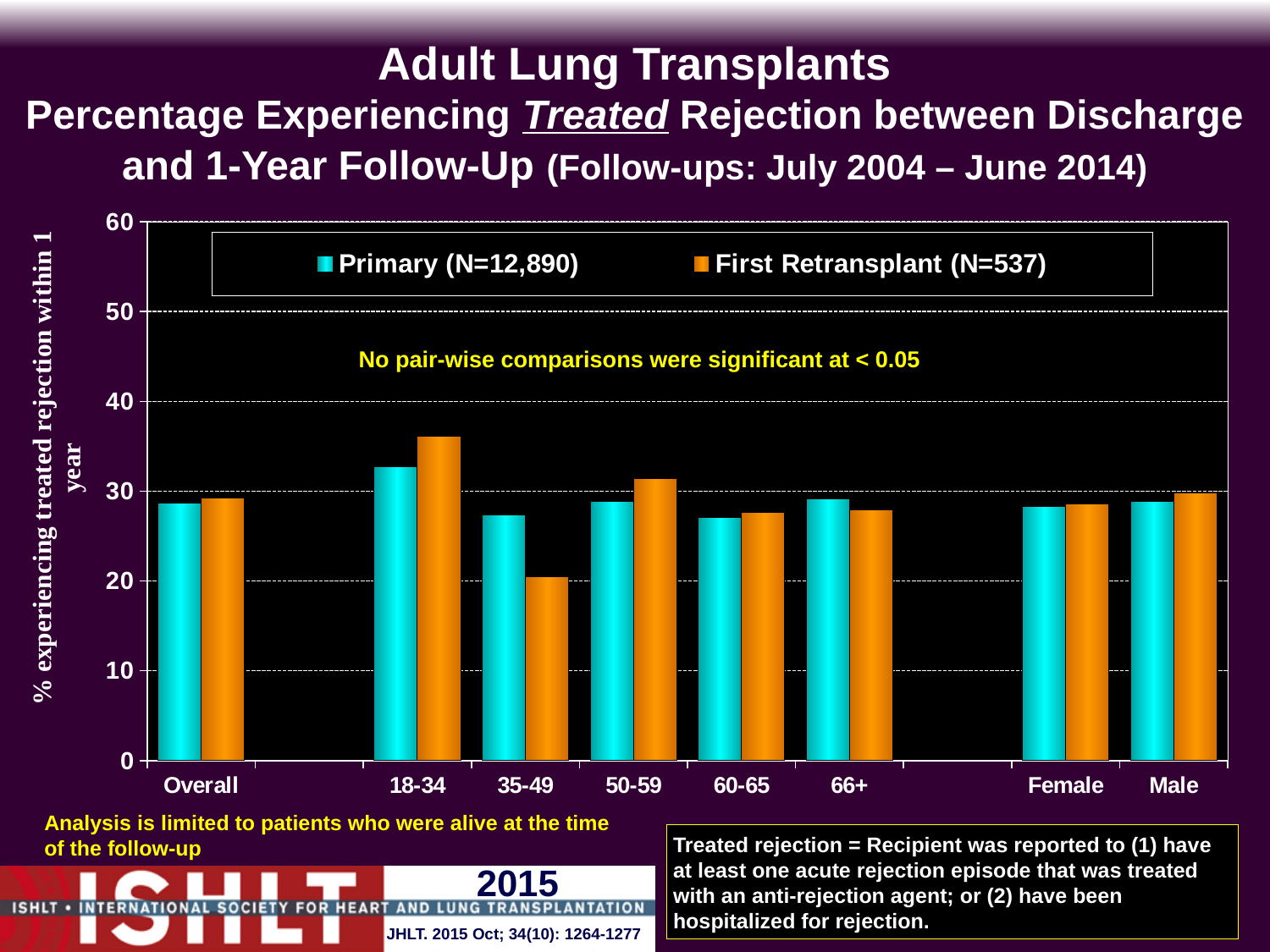
Is the First Retransplant value for 35-49 greater or less than 30? less For the 18-34 age group, which series has the larger value, Primary or First Retransplant? First Retransplant Is the Primary value for Overall greater or less than 30? less What is the sample size (N) given in the legend for the Primary series? 12,890 What kind of chart is shown on the slide? bar chart How many categories are shown along the x axis? 8 For the 35-49 age group, which series has the larger value, Primary or First Retransplant? Primary Is the First Retransplant value for 18-34 greater or less than 30? greater Which category has the highest value for the Primary (N=12,890) series? 18-34 Which category has the highest value for the First Retransplant (N=537) series? 18-34 Which category has the lowest value for the First Retransplant (N=537) series? 35-49 How many series does the legend list? 2